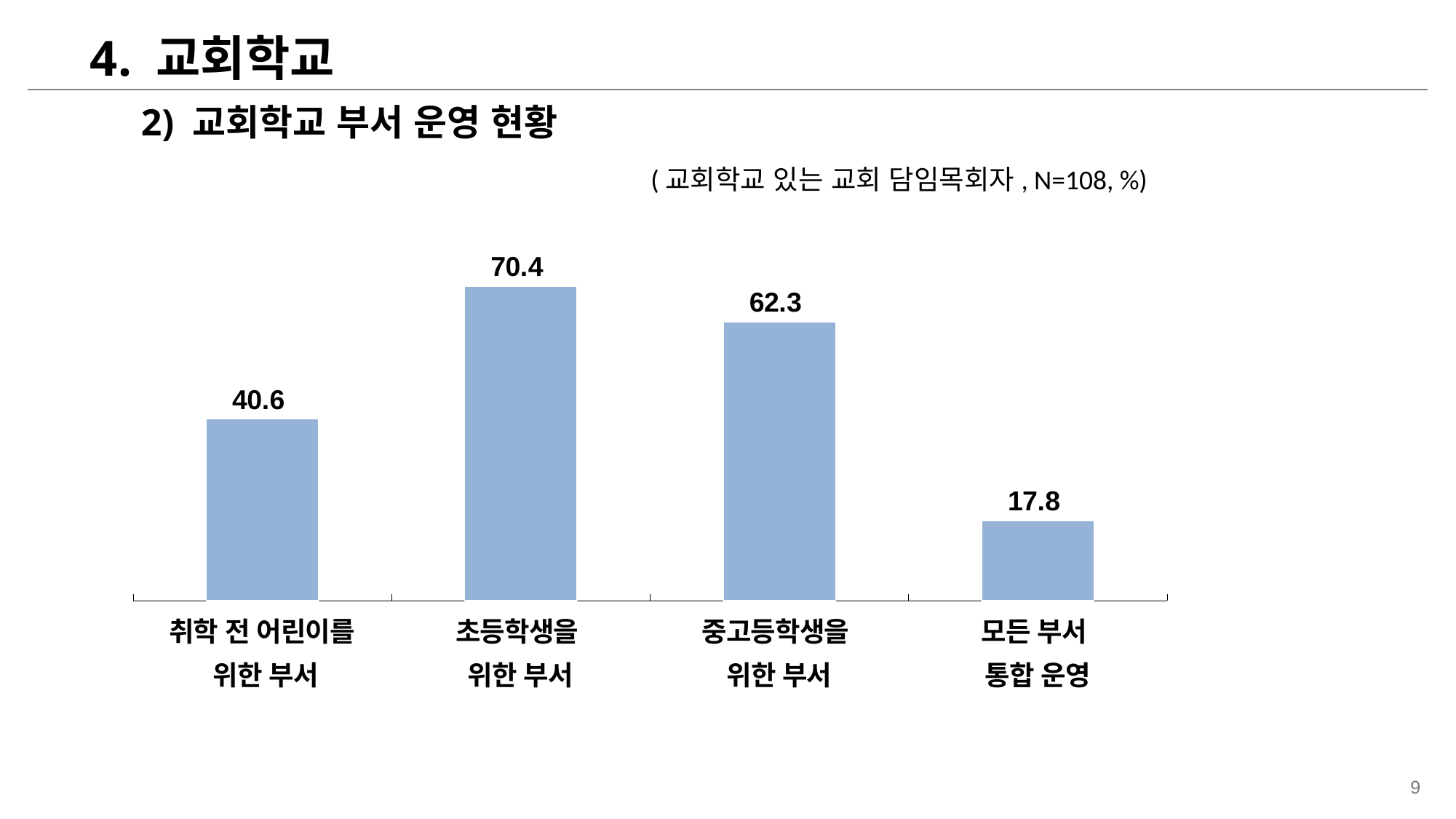
What is the difference between the values for 초등학생을 위한 부서 and 중고등학생을 위한 부서? 8.1 Which category has the lowest value? 모든 부서 통합 운영 What is the value for 모든 부서 통합 운영? 17.8 What kind of chart is shown on the slide? Bar chart Which is larger, the value for 취학 전 어린이를 위한 부서 or the value for 중고등학생을 위한 부서? 중고등학생을 위한 부서 How many categories are shown in the chart? 4 What is the value for 초등학생을 위한 부서? 70.4 What is the value for 취학 전 어린이를 위한 부서? 40.6 What is the difference between the values for 취학 전 어린이를 위한 부서 and 모든 부서 통합 운영? 22.8 Which category has the highest value? 초등학생을 위한 부서 What is the sample size (N) stated above the chart? 108 What is the value for 중고등학생을 위한 부서? 62.3